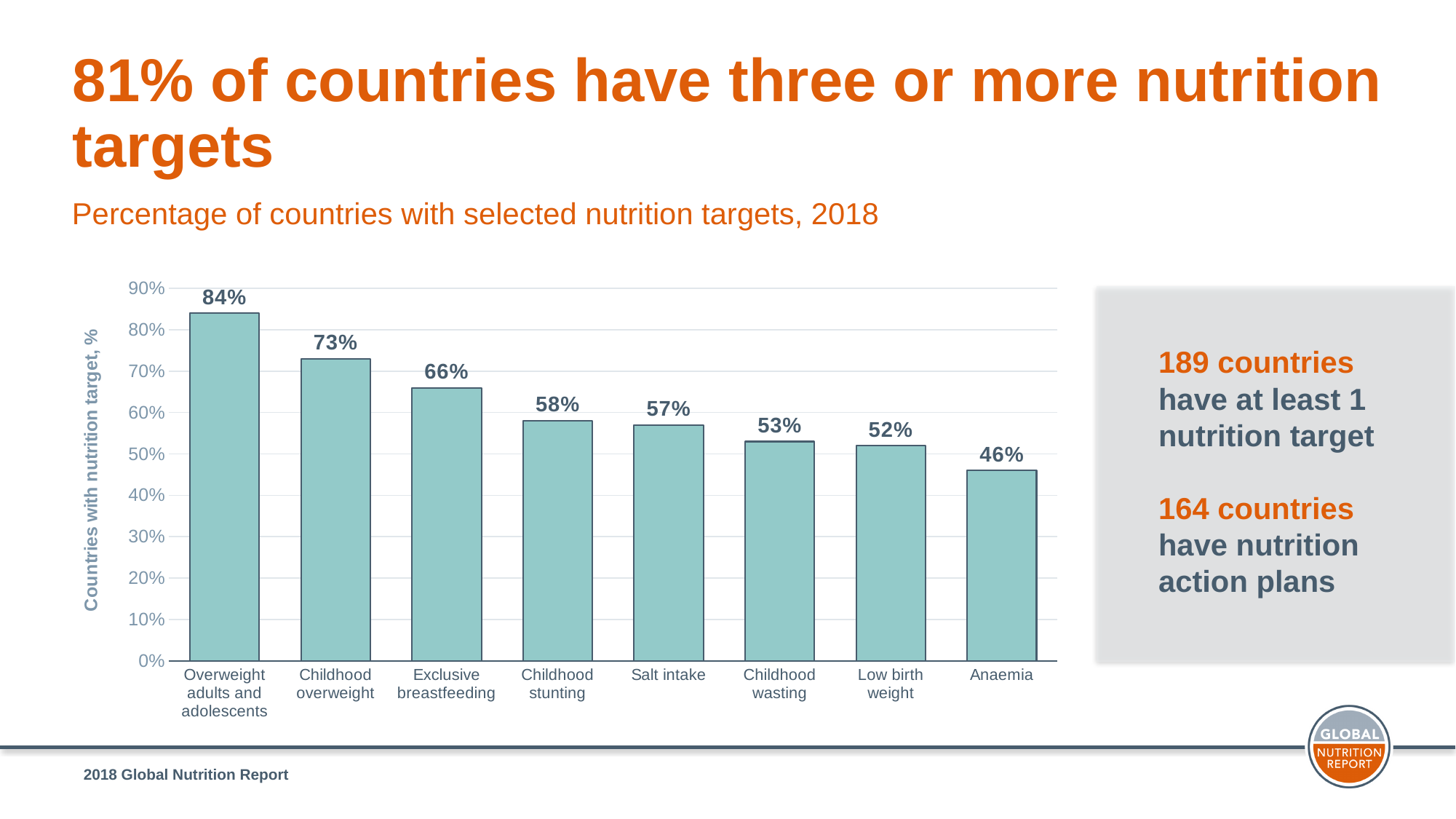
Which has a higher percentage of countries: salt intake or low birth weight? Salt intake What percentage of countries have a nutrition target for anaemia? 46% Is the value for childhood wasting greater or less than 50%? greater What percentage of countries have a nutrition target for exclusive breastfeeding? 66% What is the label of the vertical axis? Countries with nutrition target, % What percentage of countries have a nutrition target for overweight adults and adolescents? 84% Which nutrition target has the highest percentage of countries? Overweight adults and adolescents How many nutrition targets are shown on the chart? 8 What is the difference in percentage points between childhood overweight and childhood stunting? 15 Do the values rise or fall from left to right across the chart? Fall Which nutrition target has the lowest percentage of countries? Anaemia What kind of chart is shown on the slide? Bar chart